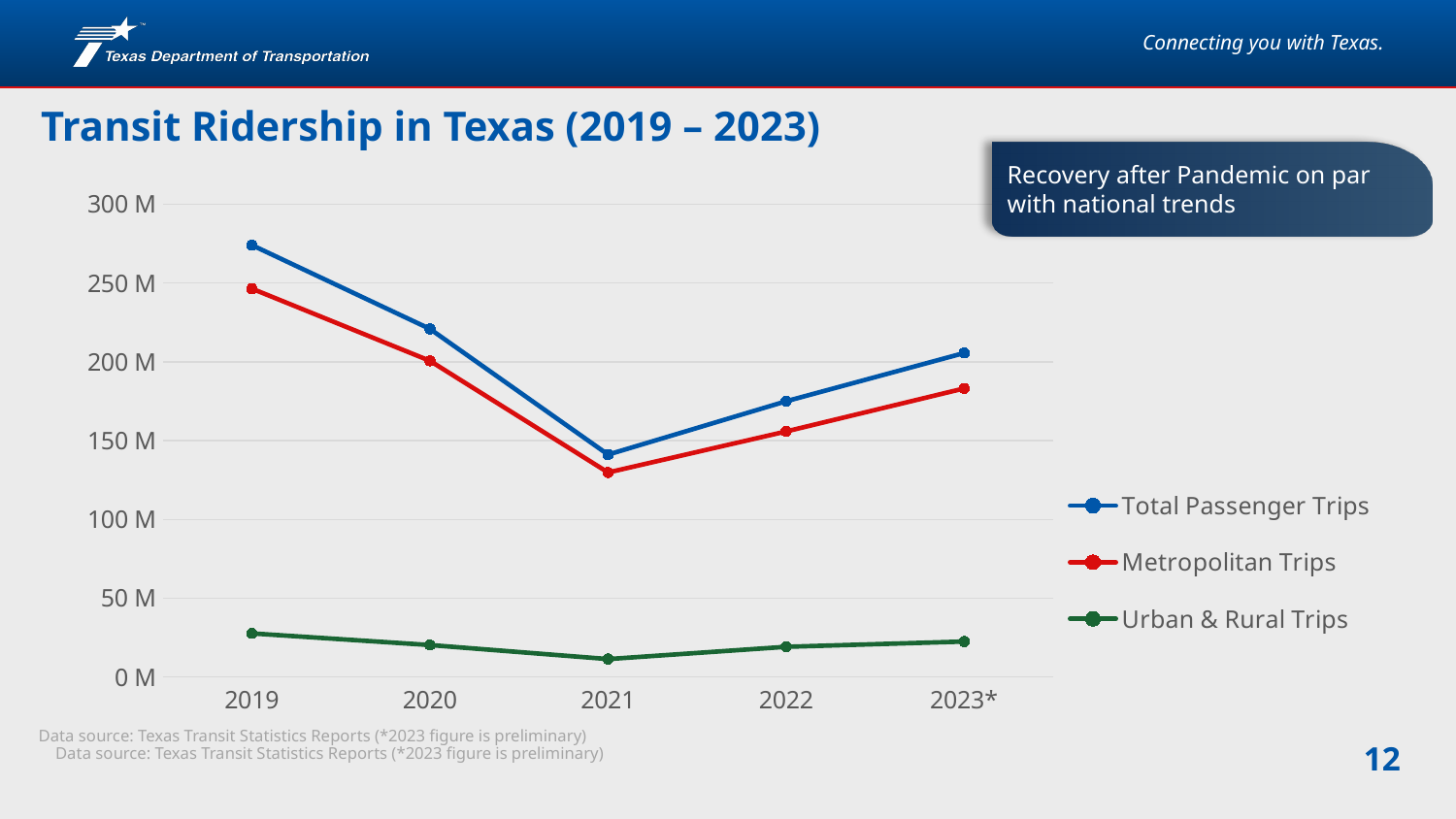
In which year are Total Passenger Trips lowest? 2021 Is the value for Urban & Rural Trips in 2019 greater or less than 50 M? less Which series is shown in green in the legend? Urban & Rural Trips How many series does the legend list? 3 Is the value for Metropolitan Trips in 2023* greater or less than 200 M? less What kind of chart is shown on the slide? Line chart Is the value for Total Passenger Trips in 2019 greater or less than 250 M? greater Which is larger: Total Passenger Trips in 2019 or in 2023*? 2019 How many years are plotted along the x axis? 5 Do Total Passenger Trips rise or fall from 2019 to 2021? fall In which year are Total Passenger Trips highest? 2019